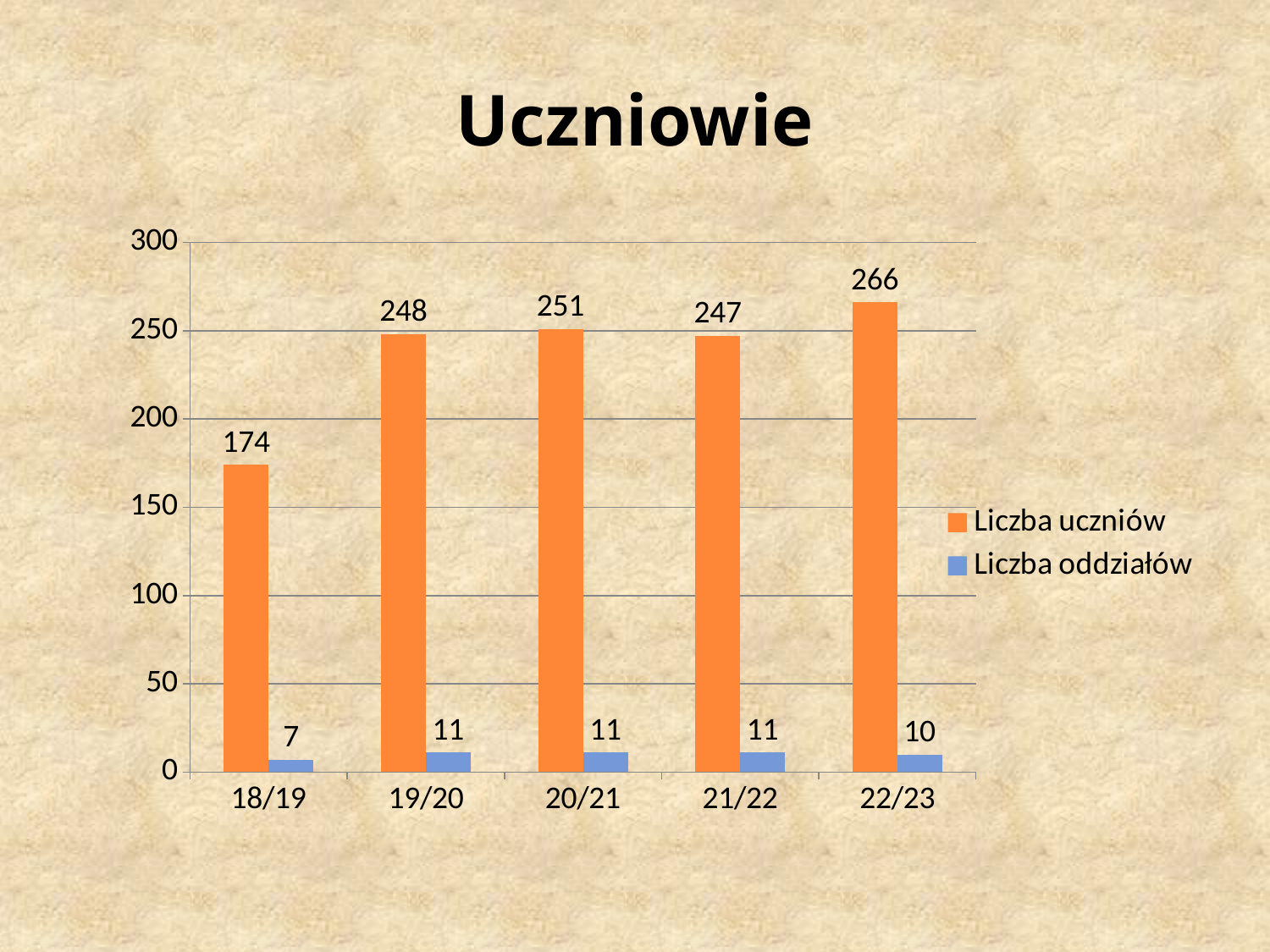
What is the difference in Liczba uczniów between 22/23 and 18/19? 92 Which is larger, Liczba uczniów for 20/21 or for 19/20? 20/21 How many school years are shown on the x axis? 5 How many series does the legend list? 2 What kind of chart is shown on the slide? bar chart Which school year has the highest Liczba uczniów? 22/23 What is the value of Liczba uczniów for 21/22? 247 Which school year has the lowest Liczba oddziałów? 18/19 What is the title of the chart? Uczniowie What is the value of Liczba uczniów for 18/19? 174 What is the value of Liczba oddziałów for 22/23? 10 Is the value of Liczba uczniów for 18/19 greater or less than 200? less